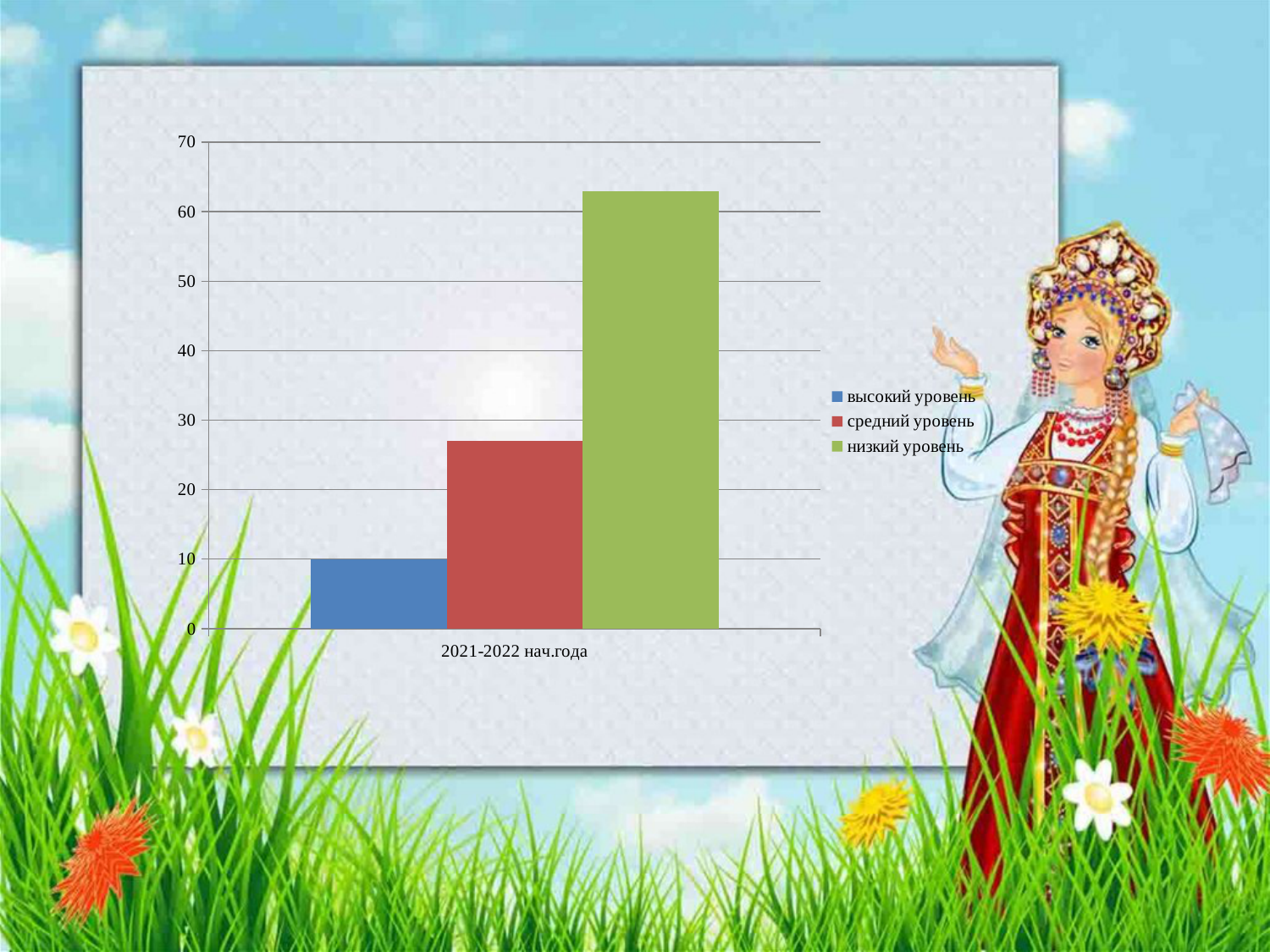
Which is larger for 2021-2022 нач.года: средний уровень or высокий уровень? средний уровень Is the value for высокий уровень greater or less than 20? less Is the value for низкий уровень greater or less than 60? greater Which series has the lowest value for 2021-2022 нач.года? высокий уровень Is the value for средний уровень greater or less than 20? greater How many series does the legend list? 3 What is the category label shown on the x axis? 2021-2022 нач.года How many categories are shown on the x axis? 1 What kind of chart is shown on the slide? bar chart What colour represents низкий уровень in the legend? green Which series has the highest value for 2021-2022 нач.года? низкий уровень